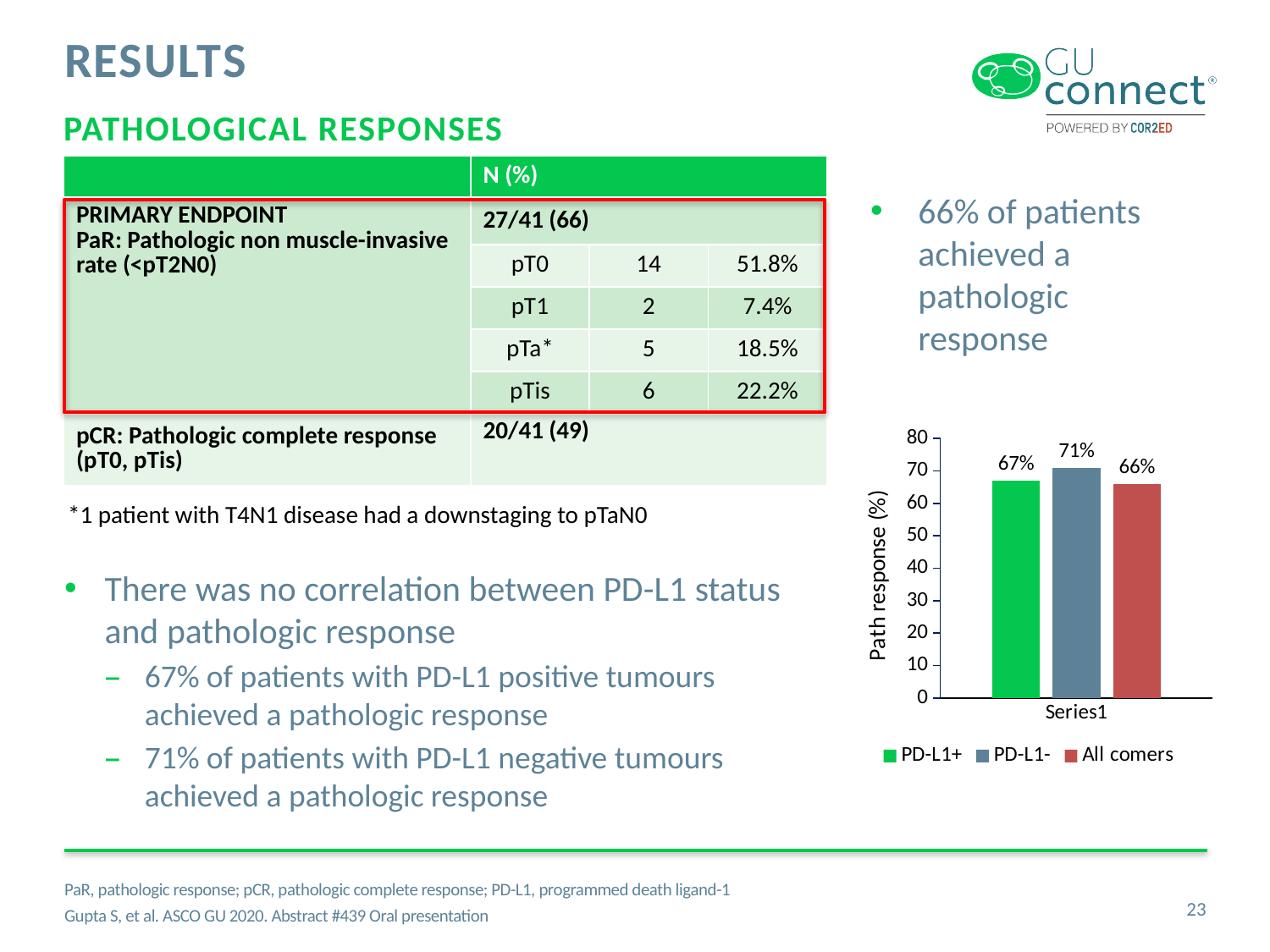
What is the path response (%) for PD-L1+? 67% Which is larger, the path response for PD-L1- or for All comers? PD-L1- What is the difference in path response between PD-L1+ and All comers? 1% What is the difference in path response between PD-L1- and PD-L1+? 4% How many series does the legend list? 3 What is the label of the y axis of the chart? Path response (%) Which series has the highest path response? PD-L1- Which series has the lowest path response? All comers What is the path response (%) for All comers? 66% Is the value for PD-L1+ greater or less than 60? greater What kind of chart is shown on the slide? Bar chart What is the path response (%) for PD-L1-? 71%